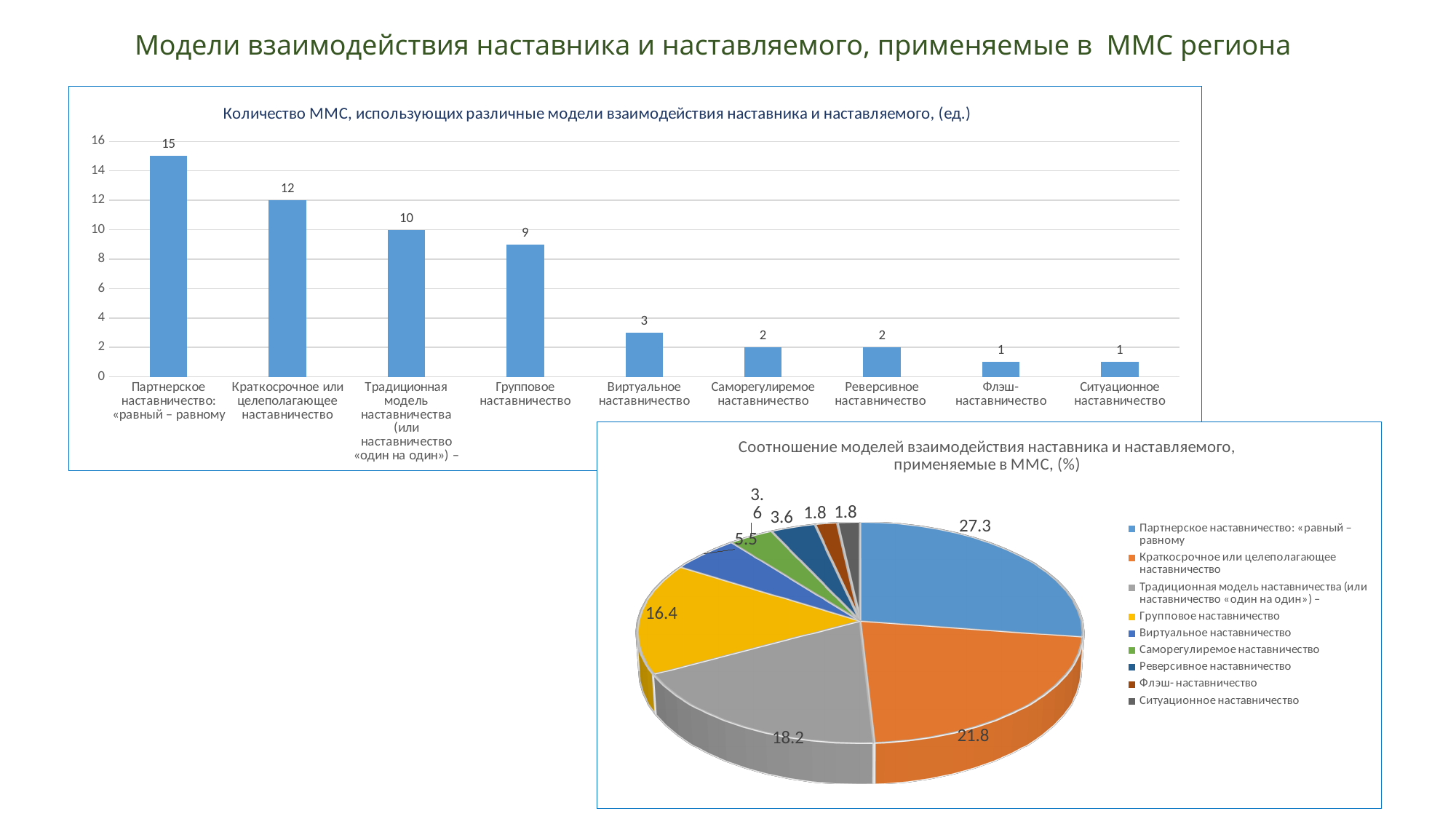
How many entries does the legend of the pie chart "Соотношение моделей взаимодействия наставника и наставляемого, применяемые в ММС, (%)" list? 9 What type of chart is the upper chart on the slide? Bar chart In the bar chart "Количество ММС, использующих различные модели взаимодействия наставника и наставляемого, (ед.)", do the values rise or fall from left to right? Fall In the bar chart "Количество ММС, использующих различные модели взаимодействия наставника и наставляемого, (ед.)", which category has the highest value? Партнерское наставничество: «равный – равному» In the bar chart "Количество ММС, использующих различные модели взаимодействия наставника и наставляемого, (ед.)", what is the difference between Краткосрочное или целеполагающее наставничество and Виртуальное наставничество? 9 In the pie chart "Соотношение моделей взаимодействия наставника и наставляемого, применяемые в ММС, (%)", what is the value for Краткосрочное или целеполагающее наставничество? 21.8 In the bar chart "Количество ММС, использующих различные модели взаимодействия наставника и наставляемого, (ед.)", what is the value for Групповое наставничество? 9 In the pie chart "Соотношение моделей взаимодействия наставника и наставляемого, применяемые в ММС, (%)", what is the share for Групповое наставничество? 16.4 How many categories are shown in the bar chart "Количество ММС, использующих различные модели взаимодействия наставника и наставляемого, (ед.)"? 9 In the bar chart "Количество ММС, использующих различные модели взаимодействия наставника и наставляемого, (ед.)", what is the value for Партнерское наставничество: «равный – равному»? 15 In the bar chart "Количество ММС, использующих различные модели взаимодействия наставника и наставляемого, (ед.)", which is larger: Традиционная модель наставничества or Групповое наставничество? Традиционная модель наставничества In the pie chart "Соотношение моделей взаимодействия наставника и наставляемого, применяемые в ММС, (%)", what colour is the slice for Партнерское наставничество: «равный – равному»? Blue